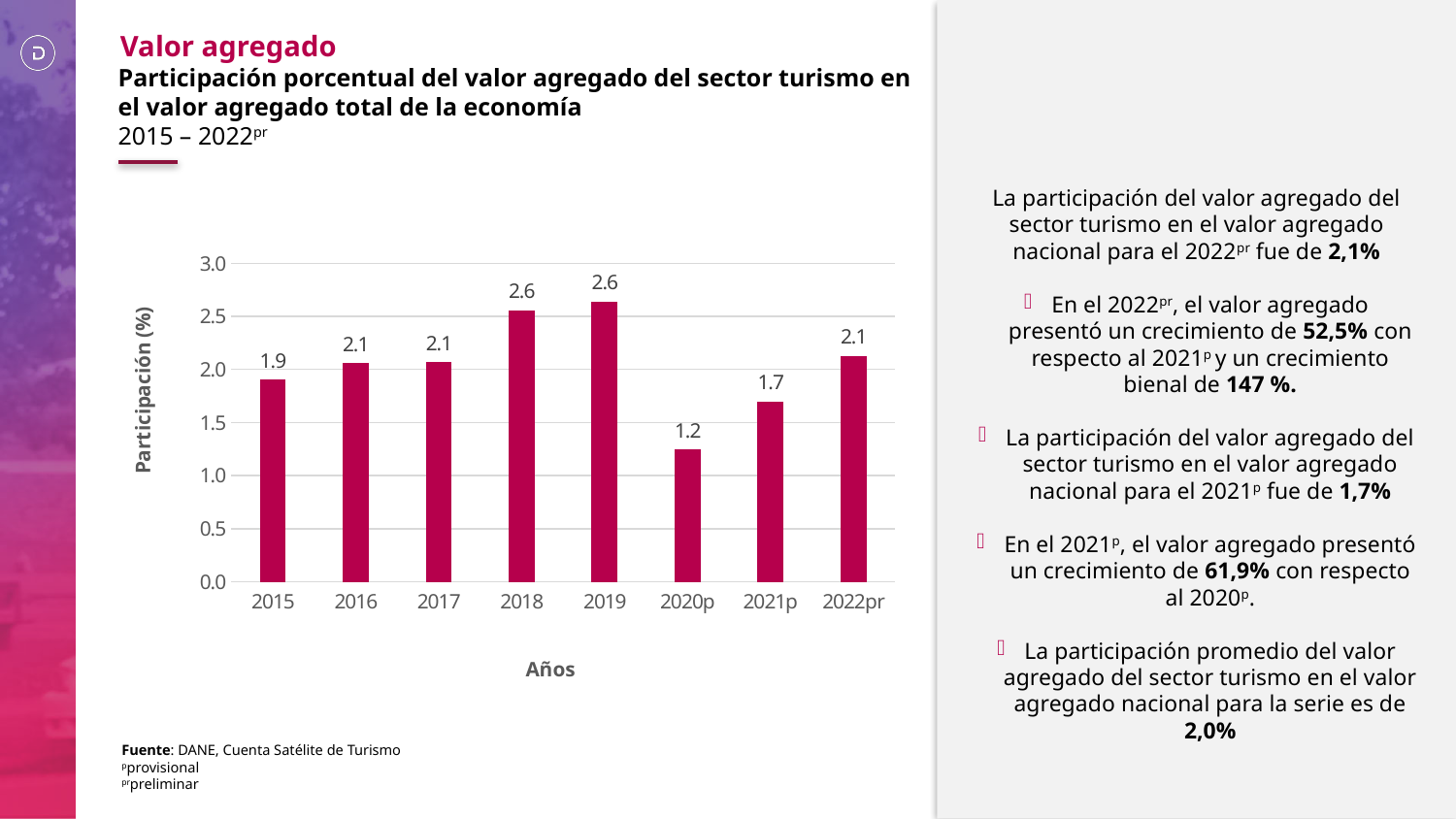
What is the value for 2020p? 1.2 Which is larger, the value for 2021p or the value for 2016? 2016 Do the values rise or fall from 2019 to 2020p? Fall What is the value for 2015? 1.9 What is the value for 2018? 2.6 What is the value for 2022pr? 2.1 Which year has the lowest value? 2020p What is the label of the y axis? Participación (%) What is the difference between the values for 2019 and 2020p? 1.4 What type of chart is shown on the slide? Bar chart How many years are shown on the x axis? 8 What is the difference between the values for 2022pr and 2021p? 0.4